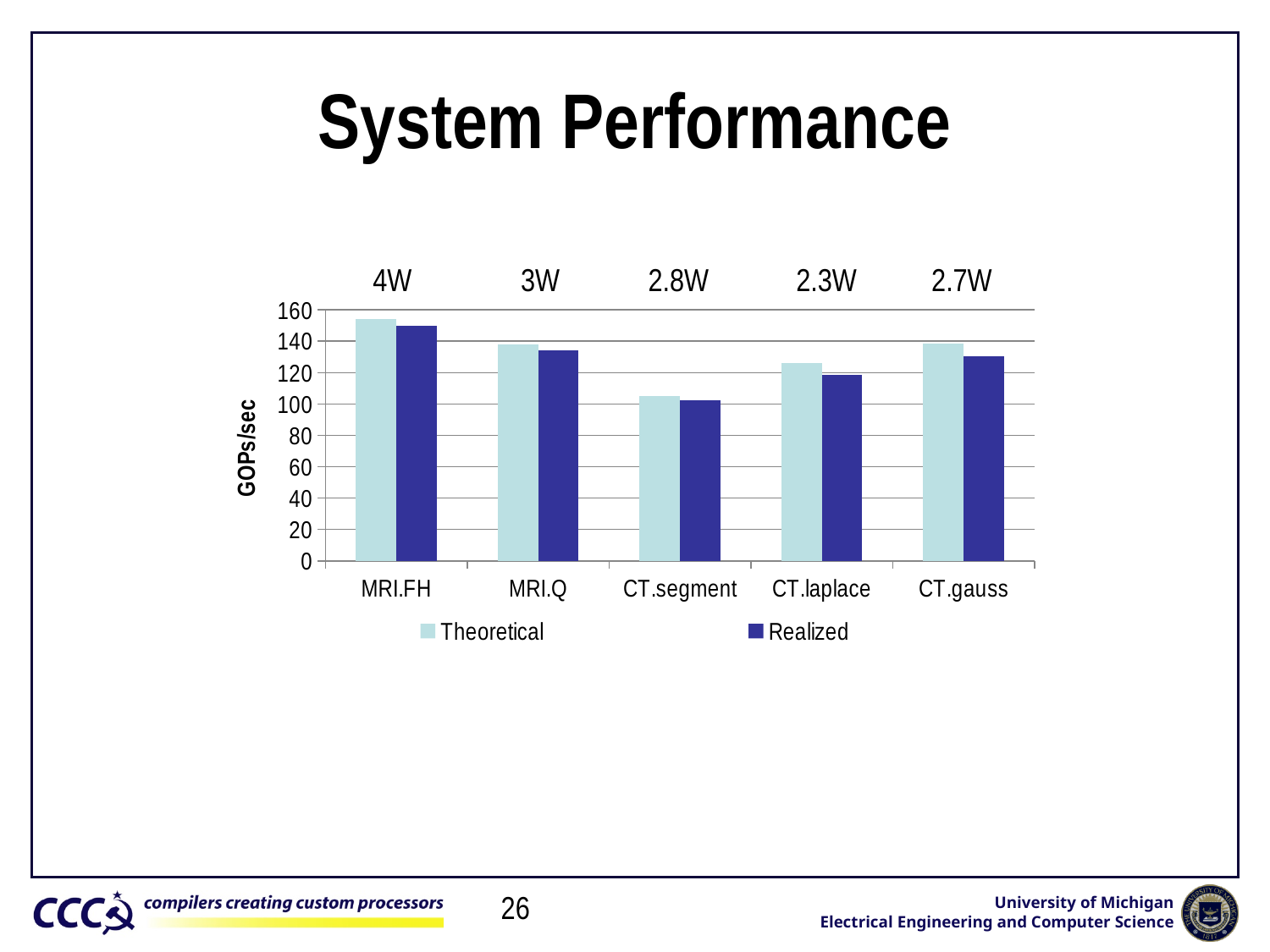
Which benchmark has the lowest Realized GOPs/sec? CT.segment For CT.laplace, which is larger, the Theoretical or the Realized value? Theoretical What kind of chart is shown on the slide? bar chart Is the Theoretical value for CT.laplace greater or less than 120? greater Which is larger, the Realized value for MRI.FH or the Realized value for CT.segment? MRI.FH How many benchmark categories are shown on the x axis? 5 How many series does the legend list? 2 What power label is printed above the CT.laplace bars? 2.3W Is the Theoretical value for MRI.FH greater or less than 140? greater What is the label on the y axis? GOPs/sec Which benchmark has the highest Theoretical GOPs/sec? MRI.FH Is the Realized value for CT.segment greater or less than 120? less